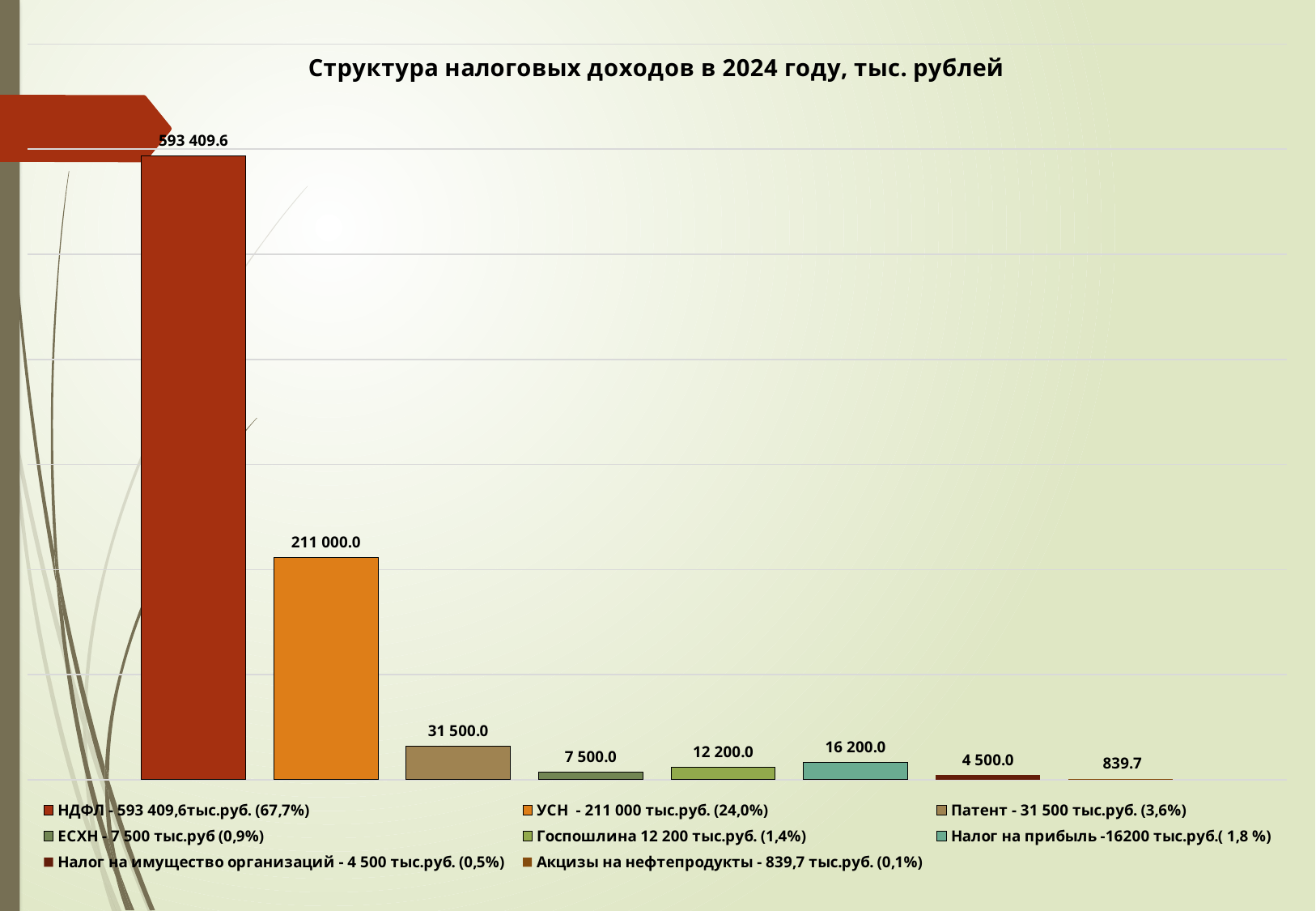
What is the value shown for Патент? 31 500.0 What is the value shown for НДФЛ? 593 409.6 How many entries does the legend list? 8 Which is larger, the value for Госпошлина or the value for Налог на прибыль? Налог на прибыль What is the value shown for Акцизы на нефтепродукты? 839.7 What type of chart is shown on the slide? bar chart Which category has the lowest value? Акцизы на нефтепродукты What is the title of the chart? Структура налоговых доходов в 2024 году, тыс. рублей What is the difference between the values for НДФЛ and УСН? 382 409.6 What is the value shown for УСН? 211 000.0 How many bars are plotted in the chart? 8 Which category has the highest value? НДФЛ